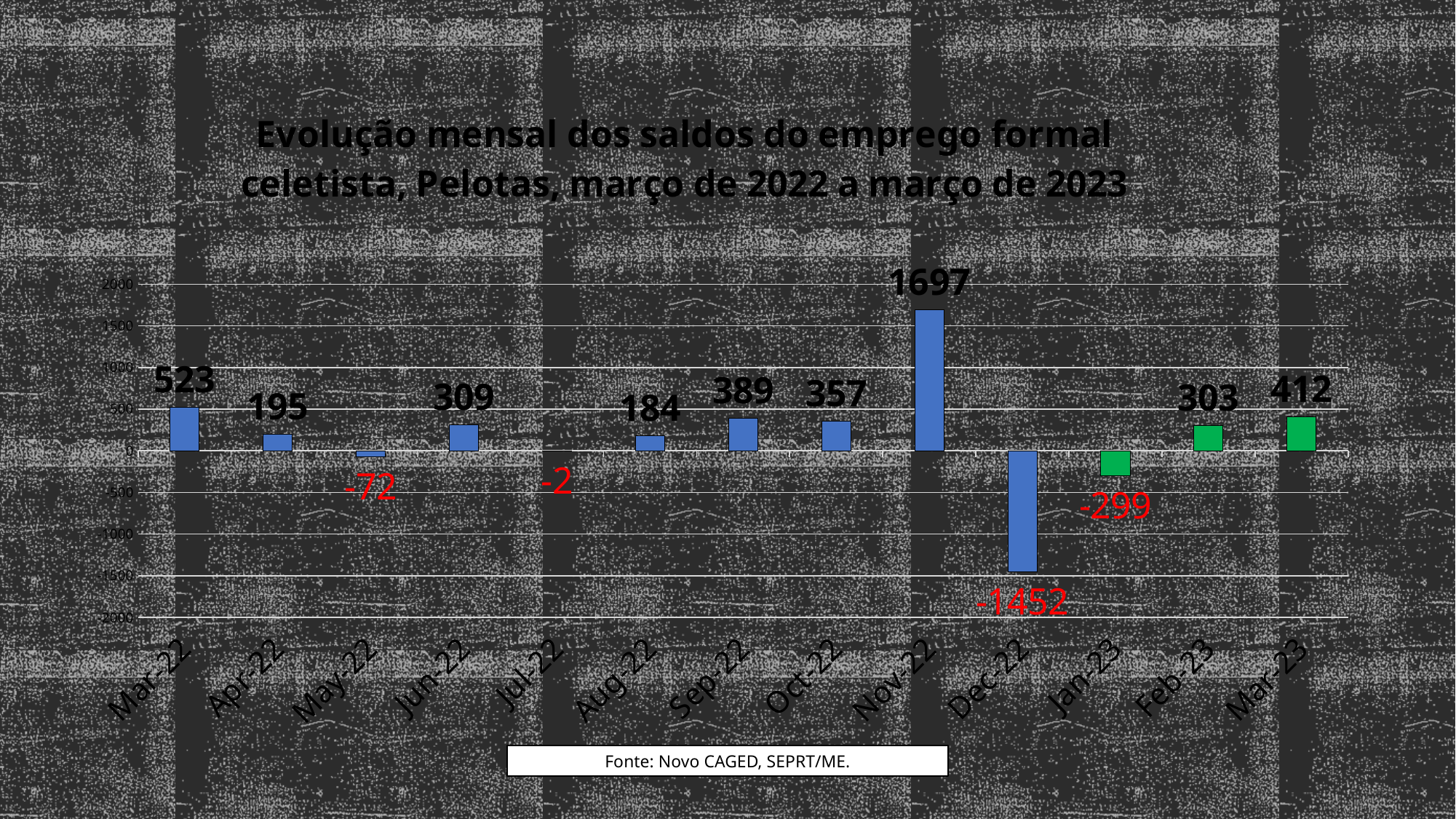
What is the value for Nov-22? 1697 What is the value for Jan-23? -299 Which month has the lowest value? Dec-22 How many months have a negative value? 4 What is the value for Mar-22? 523 What kind of chart is shown on the slide? Bar chart How many months are shown on the x axis? 13 What is the value for Dec-22? -1452 Which is larger, the value for Sep-22 or the value for Oct-22? Sep-22 Which month has the highest value? Nov-22 What is the difference between the values for Mar-23 and Feb-23? 109 What colour are the bars for the 2023 months? Green